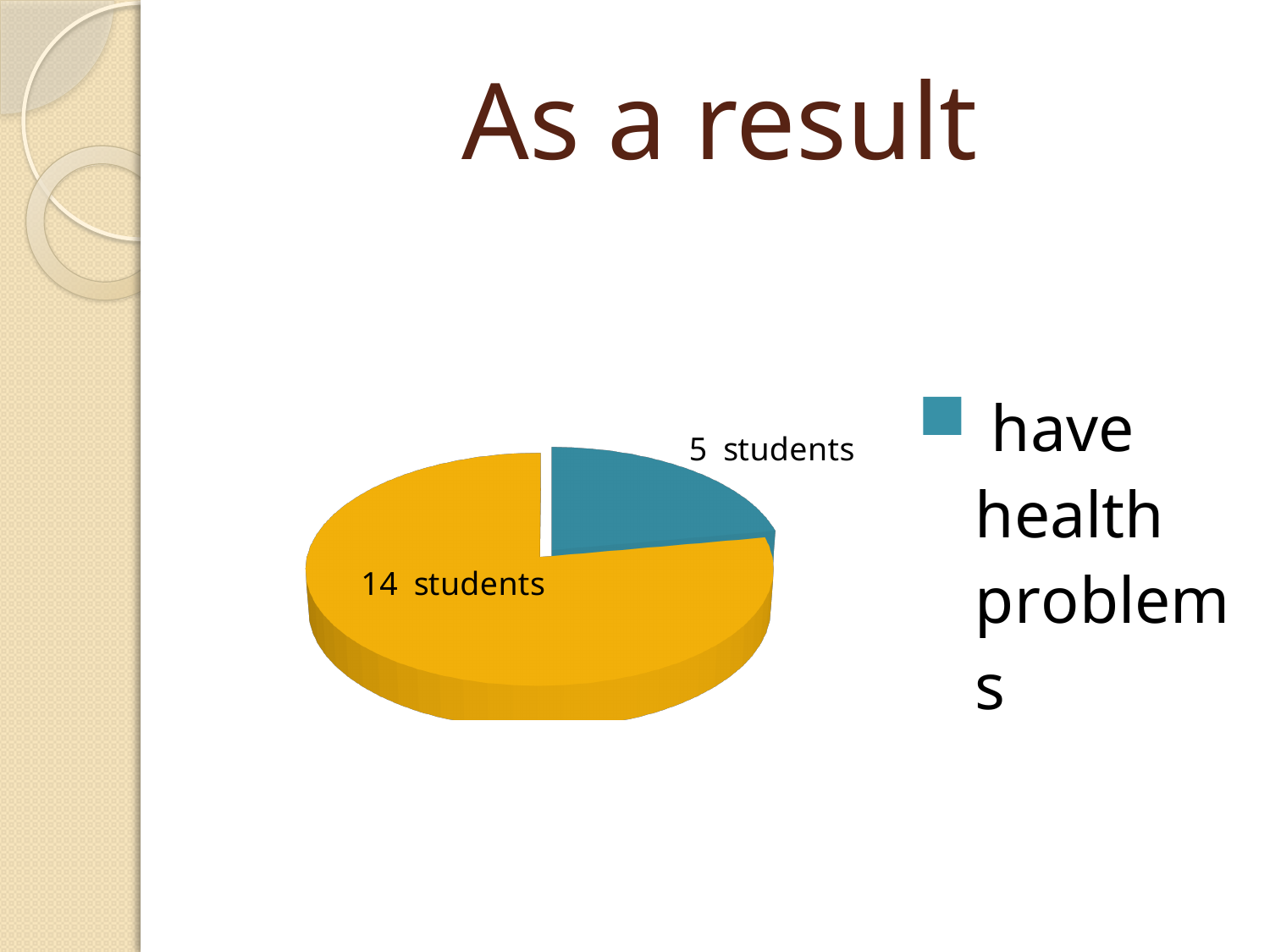
What label does the legend give for the blue slice of the pie chart? have health problems How many students have health problems according to the pie chart? 5 students How many students are represented by the yellow slice of the pie chart? 14 students How many students are represented by the blue slice of the pie chart? 5 students How many students in total are represented in the pie chart? 19 students What is the title of the slide containing the pie chart? As a result Which slice of the pie chart represents the most students? the yellow slice (14 students) What is the difference in the number of students between the yellow slice and the blue slice? 9 students What type of chart is shown on the slide? pie chart How many slices does the pie chart have? 2 Which slice of the pie chart is larger, the blue one or the yellow one? the yellow one Which slice of the pie chart represents the fewest students? the blue slice (5 students)